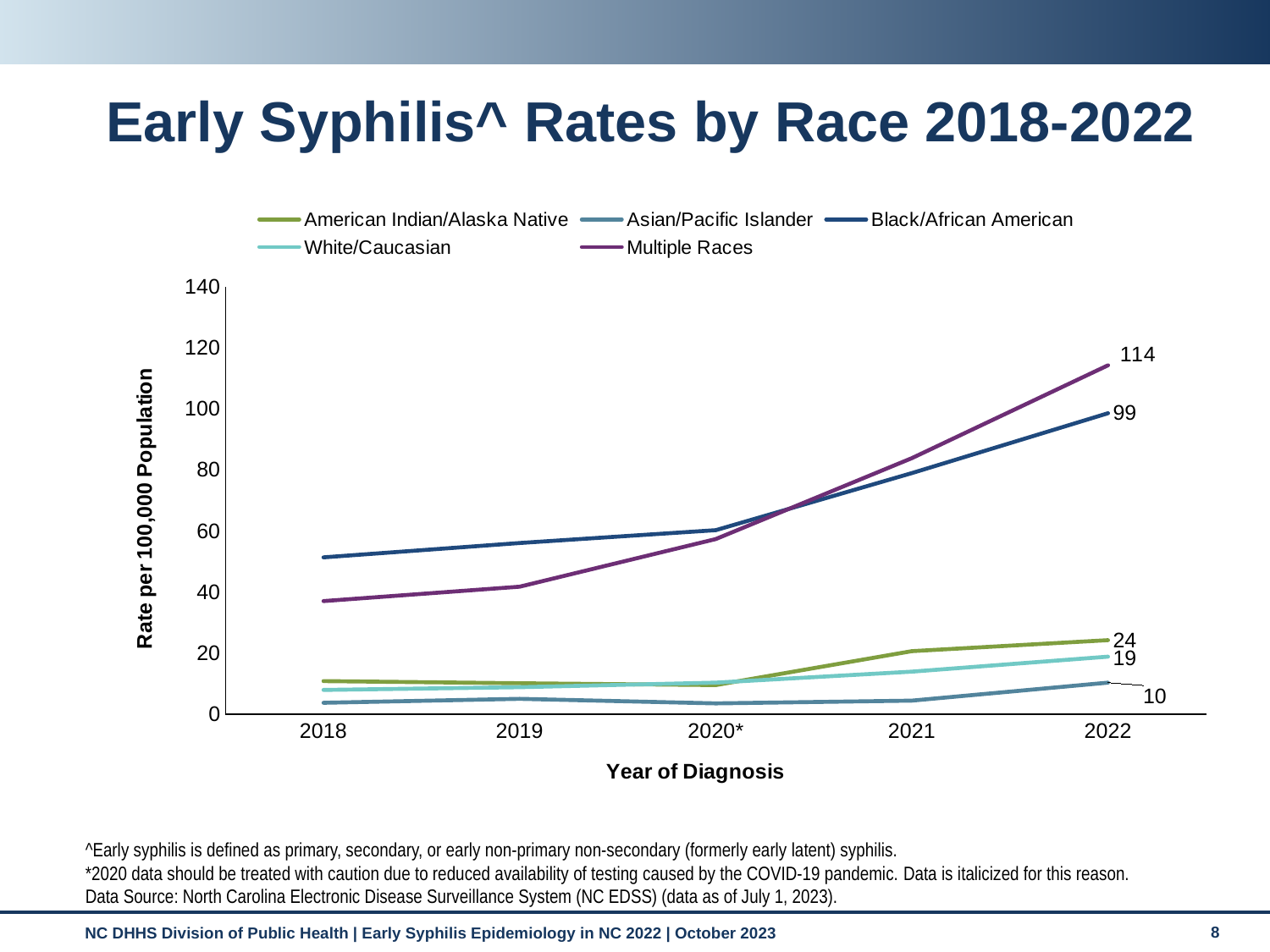
Does the rate for Multiple Races rise or fall from 2018 to 2022? rise What is the early syphilis rate for Multiple Races in 2022? 114 How many years are shown on the x axis? 5 Which race group has the highest rate in 2022? Multiple Races How many series does the legend list? 5 What is the difference between the 2022 rates for Multiple Races and Black/African American? 15 Is the rate for Black/African American in 2018 greater or less than 40? greater What type of chart is shown on the slide? line chart What is the early syphilis rate for Asian/Pacific Islander in 2022? 10 What is the early syphilis rate for Black/African American in 2022? 99 In 2022, which is larger: the rate for American Indian/Alaska Native or the rate for White/Caucasian? American Indian/Alaska Native Which race group has the lowest rate in 2022? Asian/Pacific Islander